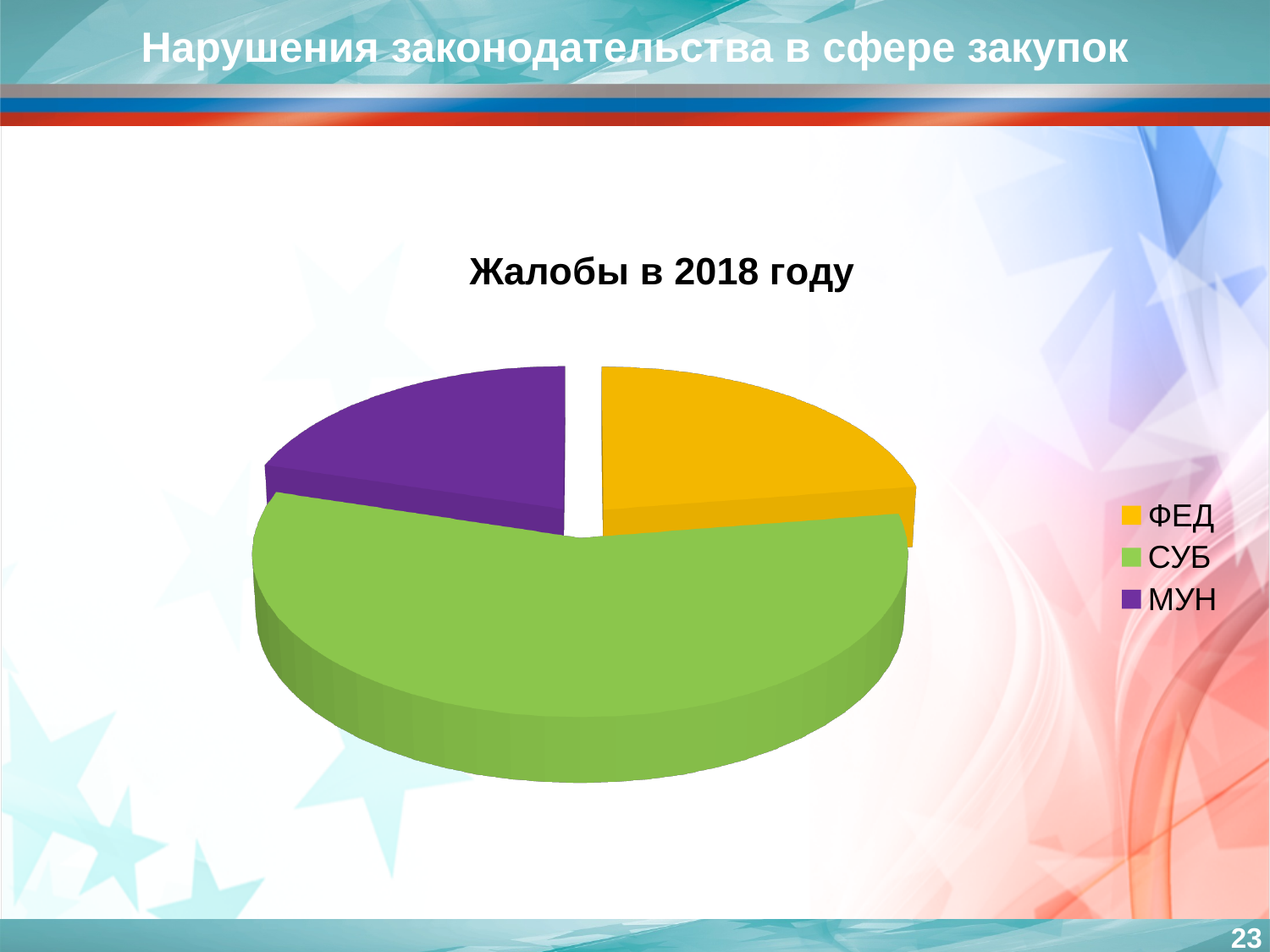
How many entries does the legend list? 3 Which colour represents СУБ in the chart? green Which slice is larger, СУБ or МУН? СУБ Which slice is larger, СУБ or ФЕД? СУБ What kind of chart is shown on the slide? pie chart What is the title of the chart? Жалобы в 2018 году Which category has the largest slice of the pie? СУБ How many slices does the pie chart have? 3